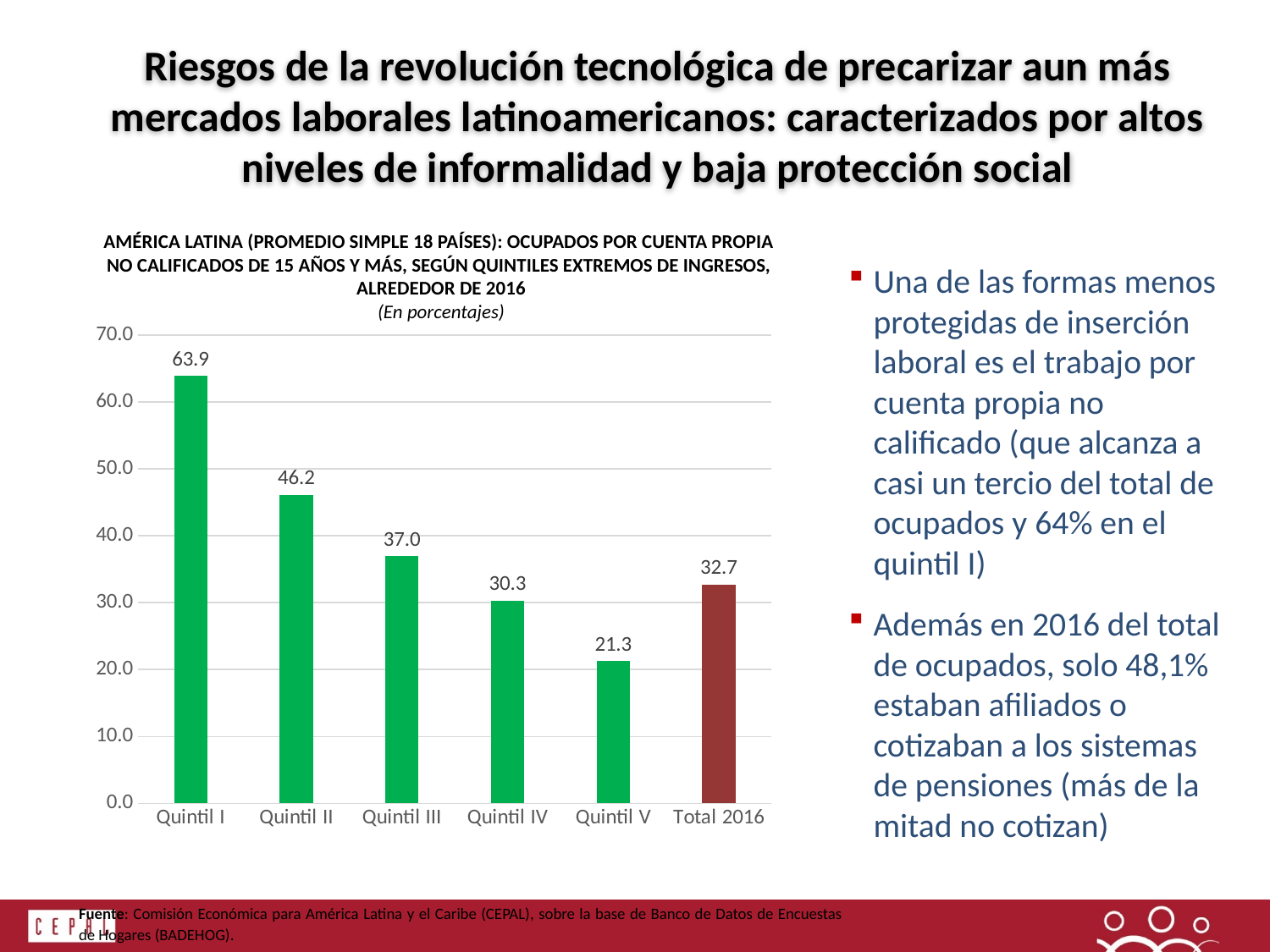
What is the value for Total 2016? 32.7 What is the value for Quintil I? 63.9 What is the difference between the values for Quintil II and Quintil III? 9.2 Is the value for Quintil II greater or less than 40.0? greater What is the difference between the values for Quintil I and Quintil V? 42.6 Do the values rise or fall from Quintil I to Quintil V? fall Which category has the lowest value? Quintil V Which category has the highest value? Quintil I How many categories are shown on the x axis? 6 What is the value for Quintil III? 37.0 What kind of chart is shown on the slide? bar chart Which is larger, the value for Quintil IV or the value for Total 2016? Total 2016